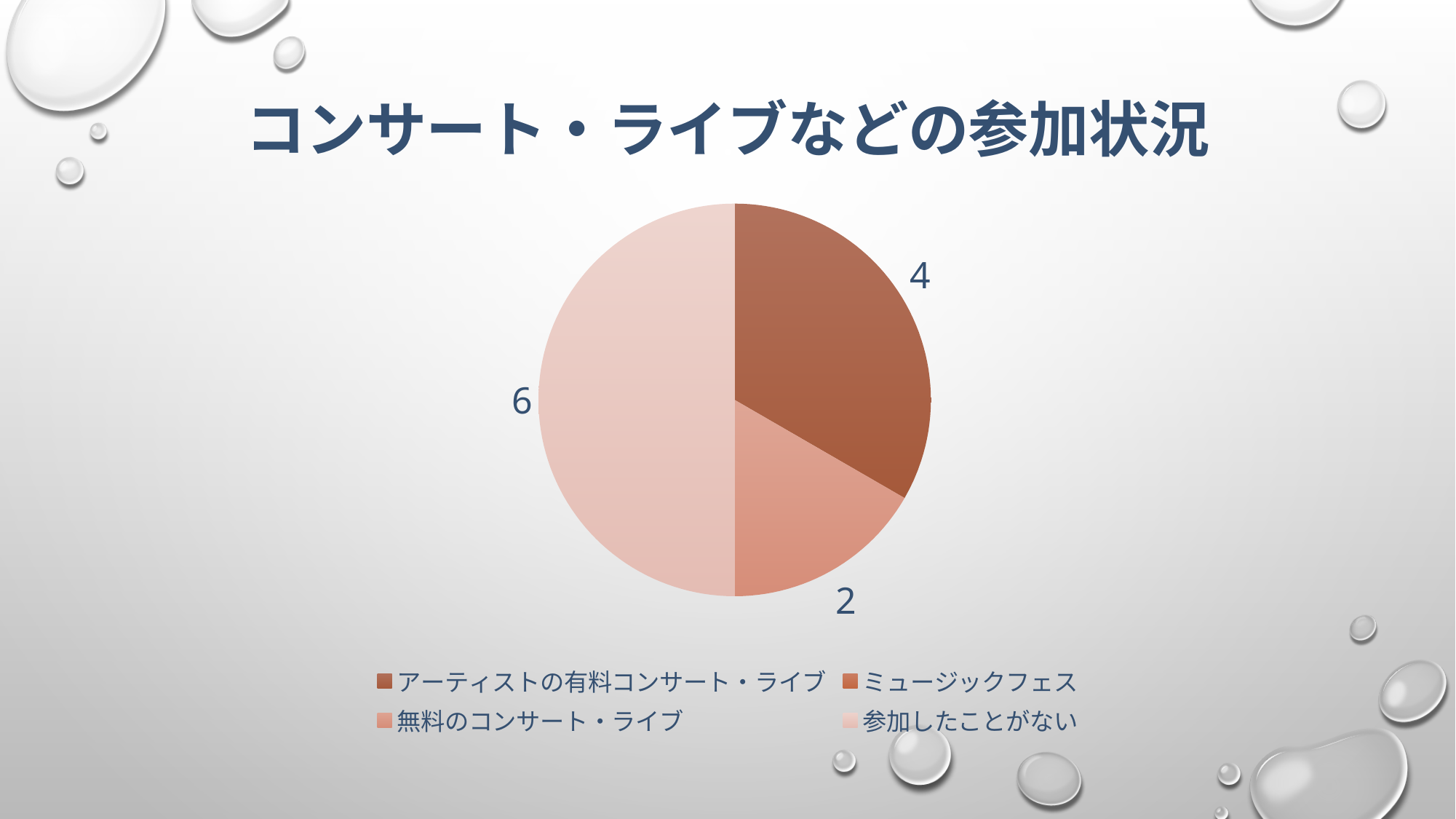
Which legend entry is shown in the lightest colour? 参加したことがない Which is larger, the value for アーティストの有料コンサート・ライブ or the value for 無料のコンサート・ライブ? アーティストの有料コンサート・ライブ What is the value for 参加したことがない? 6 What is the title of the chart? コンサート・ライブなどの参加状況 What is the difference between the values for 参加したことがない and 無料のコンサート・ライブ? 4 How many categories does the legend list? 4 What is the difference between the values for 参加したことがない and アーティストの有料コンサート・ライブ? 2 Which category has the largest slice of the pie? 参加したことがない What is the value for 無料のコンサート・ライブ? 2 What is the value for アーティストの有料コンサート・ライブ? 4 What kind of chart is shown on the slide? pie chart